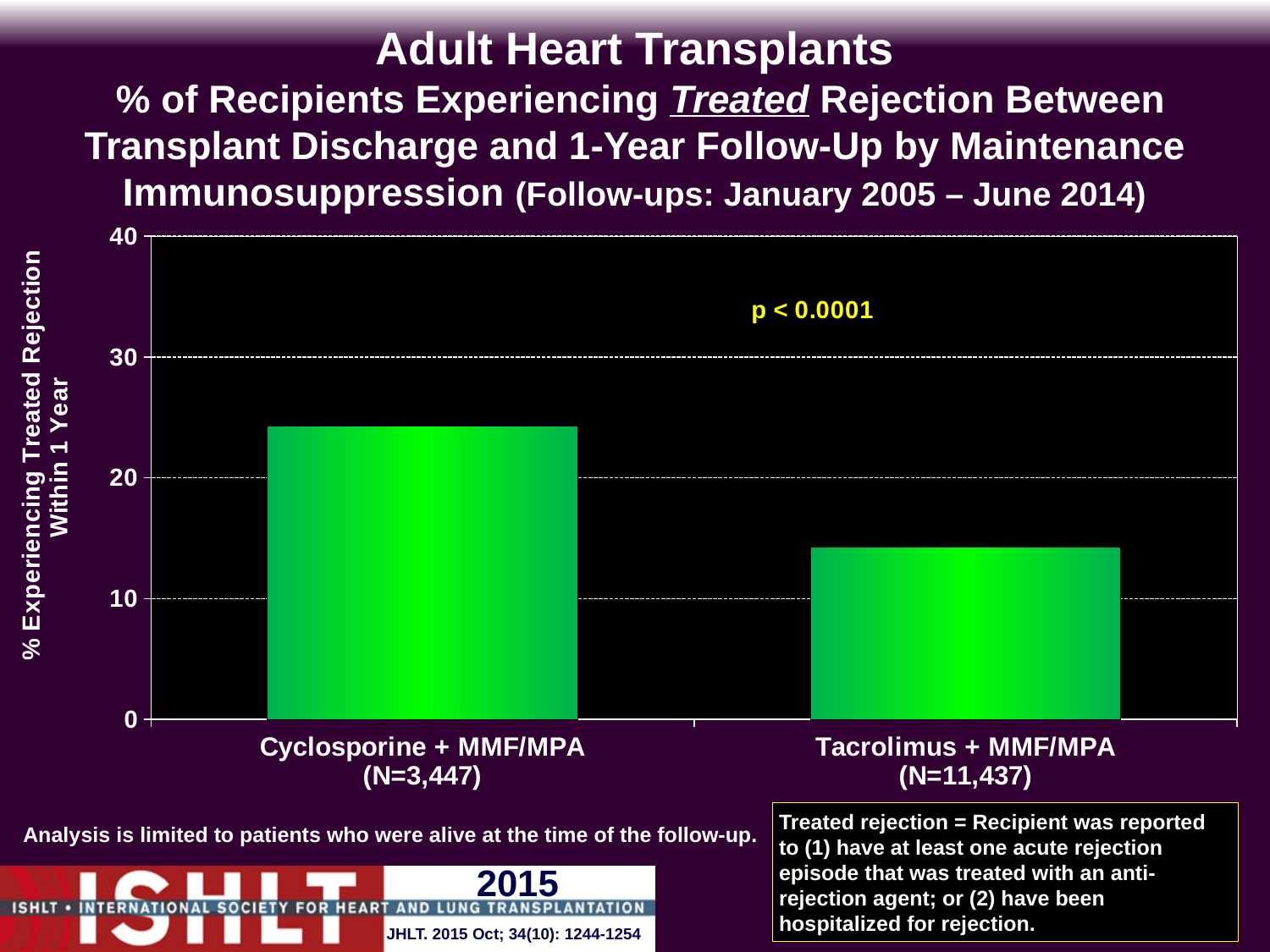
What kind of chart is shown on the slide? bar chart What is the p-value shown on the chart? p < 0.0001 Which maintenance immunosuppression group has the lower percentage of recipients experiencing treated rejection within 1 year? Tacrolimus + MMF/MPA Is the value for Cyclosporine + MMF/MPA greater or less than 20? greater How many categories (bars) are plotted in the chart? 2 Is the value for Cyclosporine + MMF/MPA larger or smaller than the value for Tacrolimus + MMF/MPA? larger Is the value for Tacrolimus + MMF/MPA greater or less than 10? greater Which maintenance immunosuppression group has the higher percentage of recipients experiencing treated rejection within 1 year? Cyclosporine + MMF/MPA Is the value for Tacrolimus + MMF/MPA greater or less than 20? less What is the label of the y-axis? % Experiencing Treated Rejection Within 1 Year